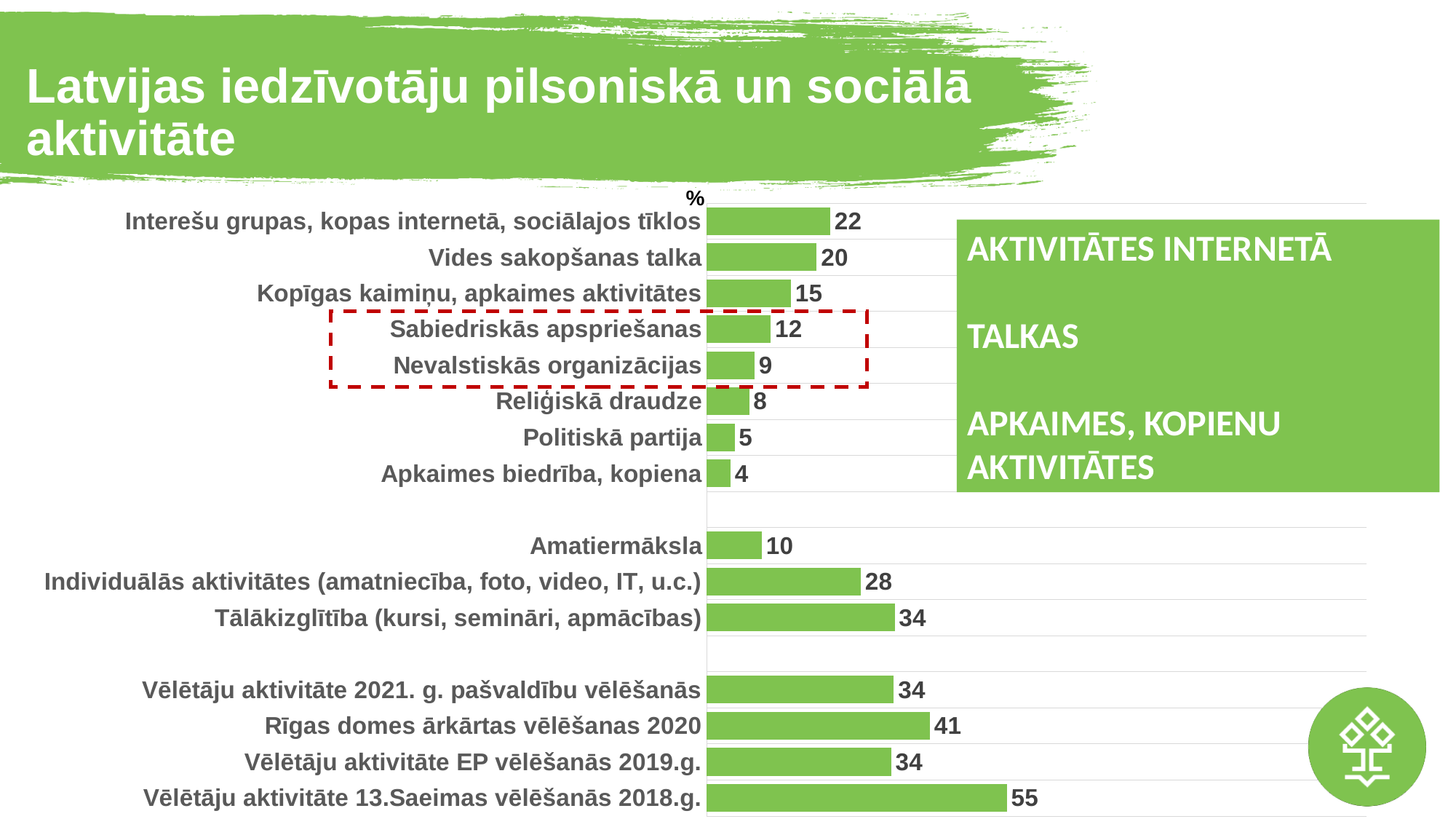
What is the difference between the values for Vēlētāju aktivitāte 13.Saeimas vēlēšanās 2018.g. and Rīgas domes ārkārtas vēlēšanas 2020? 14 What unit is indicated at the top of the chart's axis? % What kind of chart is shown on the slide? Bar chart Which category has the lowest value? Apkaimes biedrība, kopiena What is the value for Apkaimes biedrība, kopiena? 4 How many bars are plotted in the chart? 15 Which category has the highest value? Vēlētāju aktivitāte 13.Saeimas vēlēšanās 2018.g. What is the value for Vides sakopšanas talka? 20 What is the value for Rīgas domes ārkārtas vēlēšanas 2020? 41 Which is larger, the value for Individuālās aktivitātes (amatniecība, foto, video, IT, u.c.) or the value for Amatiermāksla? Individuālās aktivitātes (amatniecība, foto, video, IT, u.c.) What is the value for Nevalstiskās organizācijas? 9 What is the difference between the values for Interešu grupas, kopas internetā, sociālajos tīklos and Sabiedriskās apspriešanas? 10